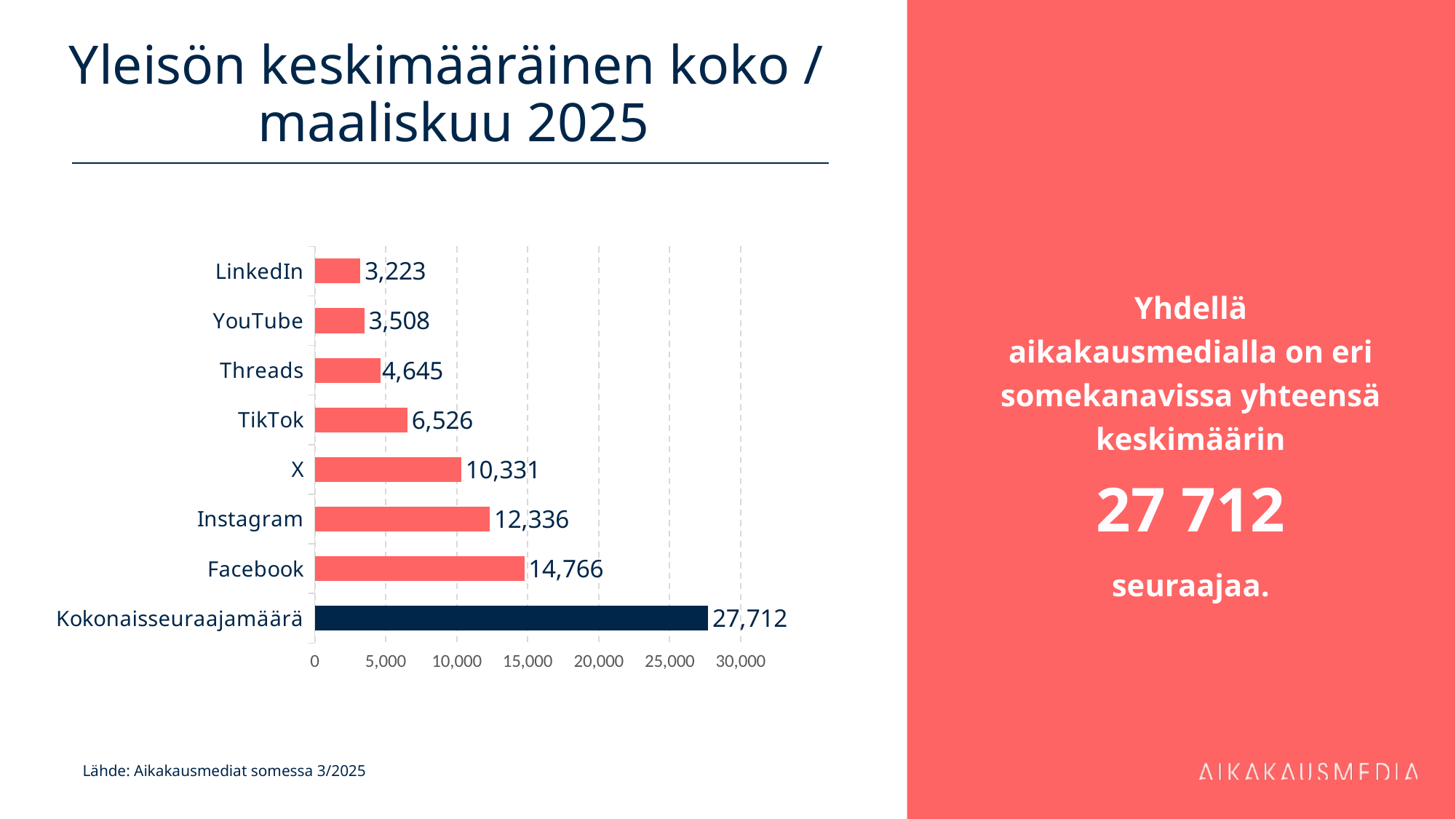
What kind of chart is shown on the slide? Bar chart What is the difference between the values for YouTube and LinkedIn? 285 What is the value for Facebook? 14,766 Which category has the highest value? Kokonaisseuraajamäärä How many categories are shown in the chart? 8 Which category has the lowest value? LinkedIn What is the difference between the values for Facebook and Instagram? 2,430 Which is larger, the value for X or the value for TikTok? X What is the value for TikTok? 6,526 Is the value for Instagram greater or less than 10,000? greater What is the value for Kokonaisseuraajamäärä? 27,712 What is the title of the slide containing the chart? Yleisön keskimääräinen koko / maaliskuu 2025